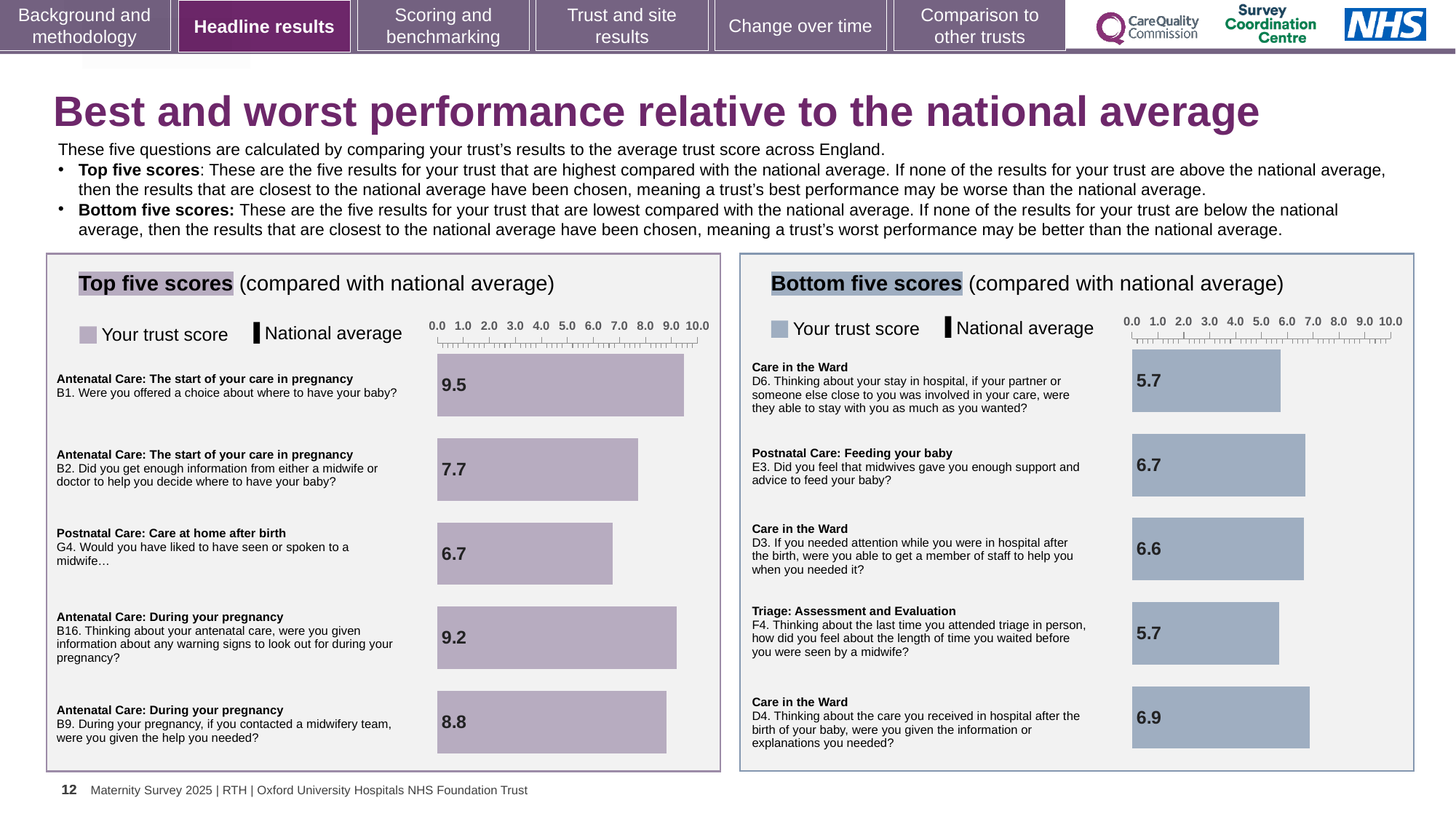
In the Bottom five scores chart, which question has the highest trust score? D4 (6.9) In the Bottom five scores chart, what is the trust score for D4 (were you given the information or explanations you needed?)? 6.9 In the Top five scores chart, what is the trust score for B16 (information about any warning signs to look out for during your pregnancy)? 9.2 What type of chart is used for the Top five scores? Bar chart In the Bottom five scores chart, what is the difference between the scores for D4 and D6? 1.2 In the Top five scores chart, is the score for B9 greater or less than 8.0? greater In the Top five scores chart, what is the difference between the scores for B1 and B2? 1.8 In the Top five scores chart, which question has the highest trust score? B1 (9.5) In the Bottom five scores chart, which has the larger score: E3 or D3? E3 (6.7) In the Top five scores chart, what is the trust score for B1 (Were you offered a choice about where to have your baby?)? 9.5 How many questions are shown in the Bottom five scores chart? 5 In the Top five scores chart, which question has the lowest trust score? G4 (6.7)